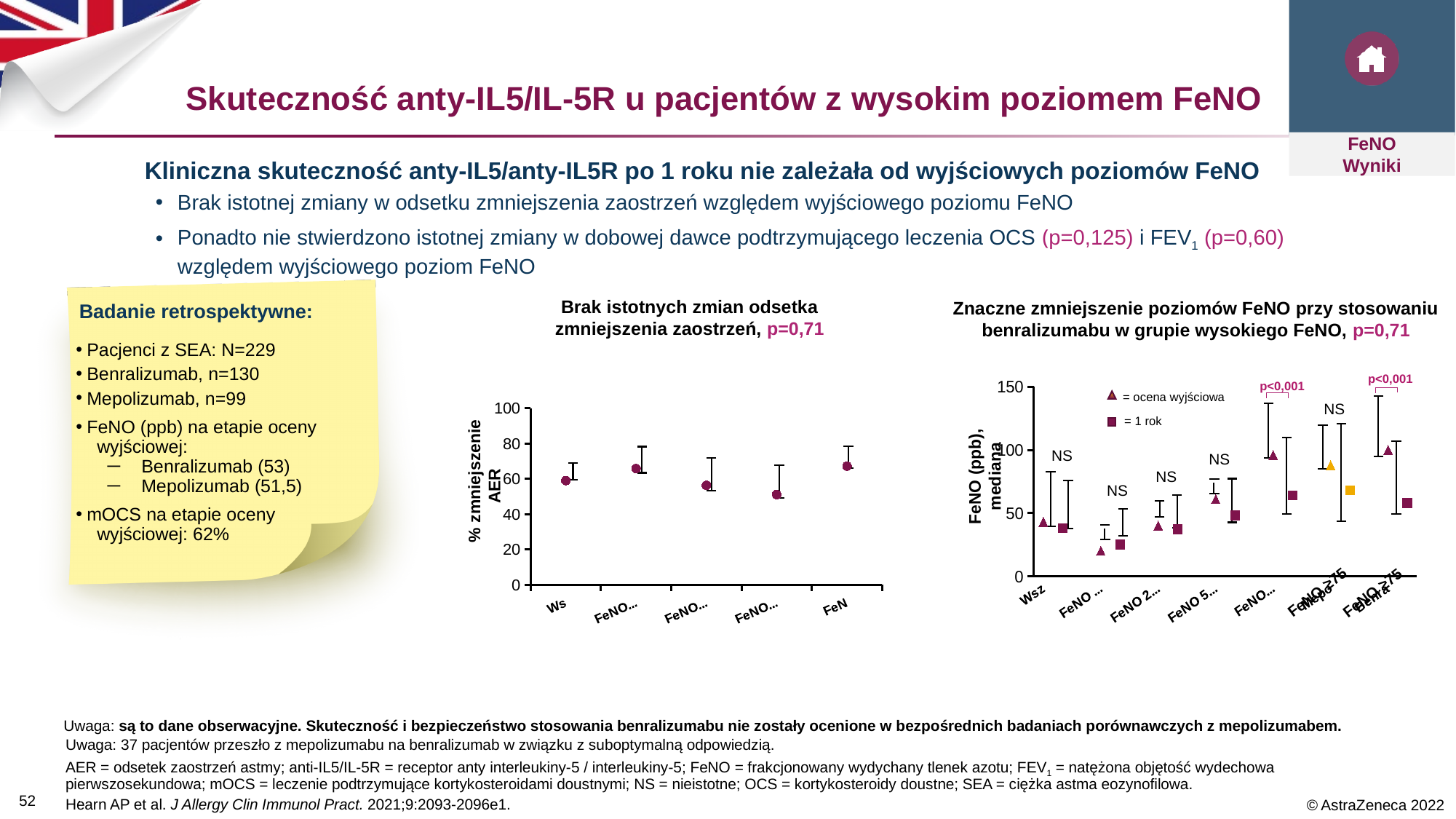
On the left chart "Brak istotnych zmian odsetka zmniejszenia zaostrzeń", is the value for the rightmost point greater or less than 40? greater On the left chart "Brak istotnych zmian odsetka zmniejszenia zaostrzeń", what is the y-axis label? % zmniejszenie AER On the right chart "Znaczne zmniejszenie poziomów FeNO przy stosowaniu benralizumabu w grupie wysokiego FeNO", is the 1 rok value for Wsz greater or less than 50? less On the right chart "Znaczne zmniejszenie poziomów FeNO przy stosowaniu benralizumabu w grupie wysokiego FeNO", what is the p-value shown in the chart title? p=0,71 How many data points (categories) are plotted on the left chart "Brak istotnych zmian odsetka zmniejszenia zaostrzeń"? 5 What kind of chart is the left chart titled "Brak istotnych zmian odsetka zmniejszenia zaostrzeń"? scatter (dot) plot with error bars On the right chart "Znaczne zmniejszenie poziomów FeNO przy stosowaniu benralizumabu w grupie wysokiego FeNO", is the baseline (ocena wyjściowa) value for Wsz greater or less than 100? less How many series does the legend list on the right chart "Znaczne zmniejszenie poziomów FeNO przy stosowaniu benralizumabu w grupie wysokiego FeNO"? 2 On the right chart "Znaczne zmniejszenie poziomów FeNO przy stosowaniu benralizumabu w grupie wysokiego FeNO", what does the triangle marker represent according to the legend? ocena wyjściowa On the left chart "Brak istotnych zmian odsetka zmniejszenia zaostrzeń", what is the highest tick shown on the y-axis? 100 On the right chart "Znaczne zmniejszenie poziomów FeNO przy stosowaniu benralizumabu w grupie wysokiego FeNO", what is the highest tick shown on the y-axis? 150